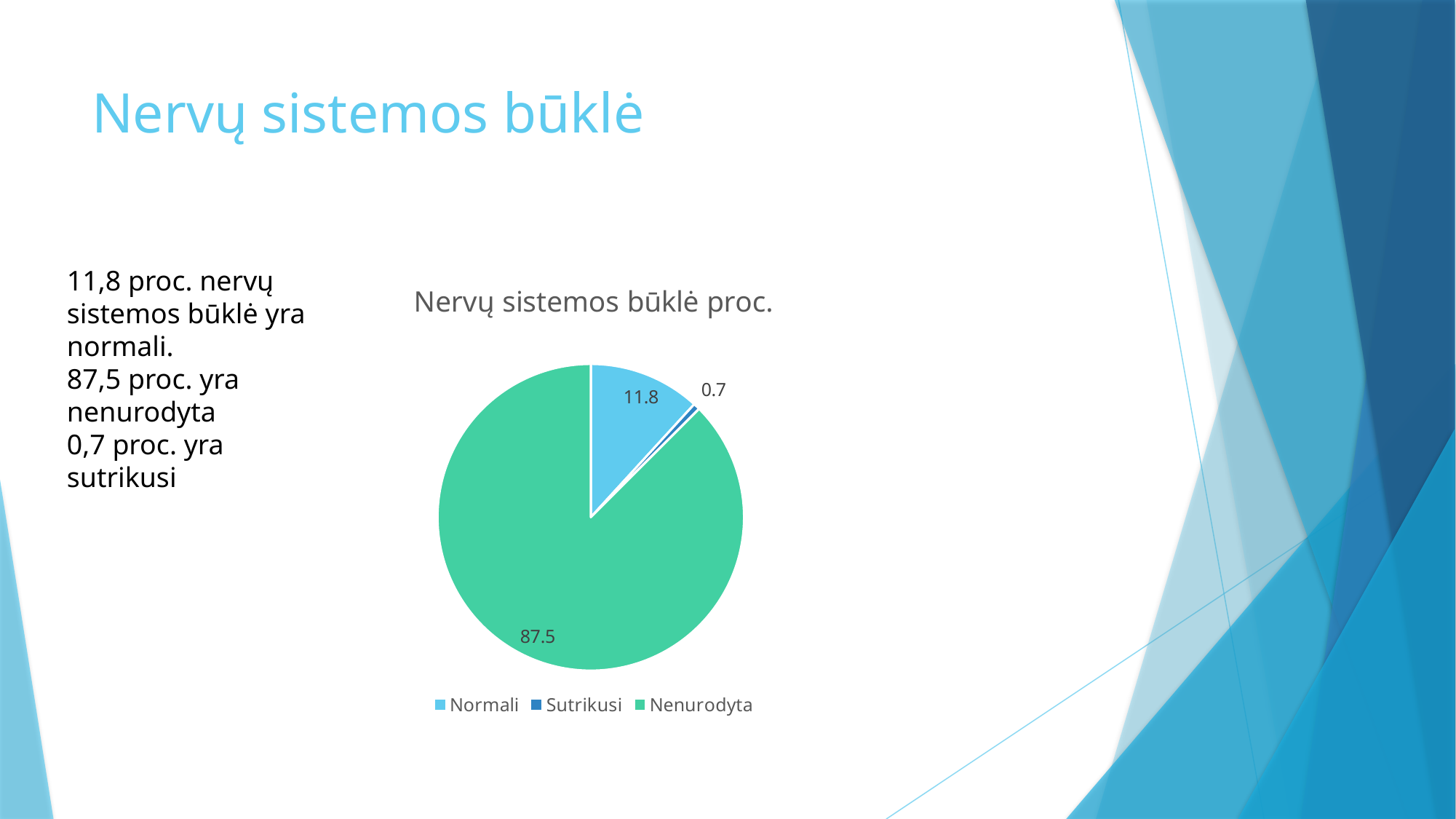
What is the value for Normali? 11.8 What is the chart's title? Nervų sistemos būklė proc. What is the value for Sutrikusi? 0.7 What is the difference between the values for Nenurodyta and Normali? 75.7 How many categories does the pie chart have? 3 What type of chart is shown on the slide? pie chart What is the value for Nenurodyta? 87.5 Which category has the largest slice? Nenurodyta Which category has the smallest slice? Sutrikusi How many entries does the legend list? 3 What colour is the Nenurodyta slice? green Which is larger, the value for Normali or the value for Sutrikusi? Normali